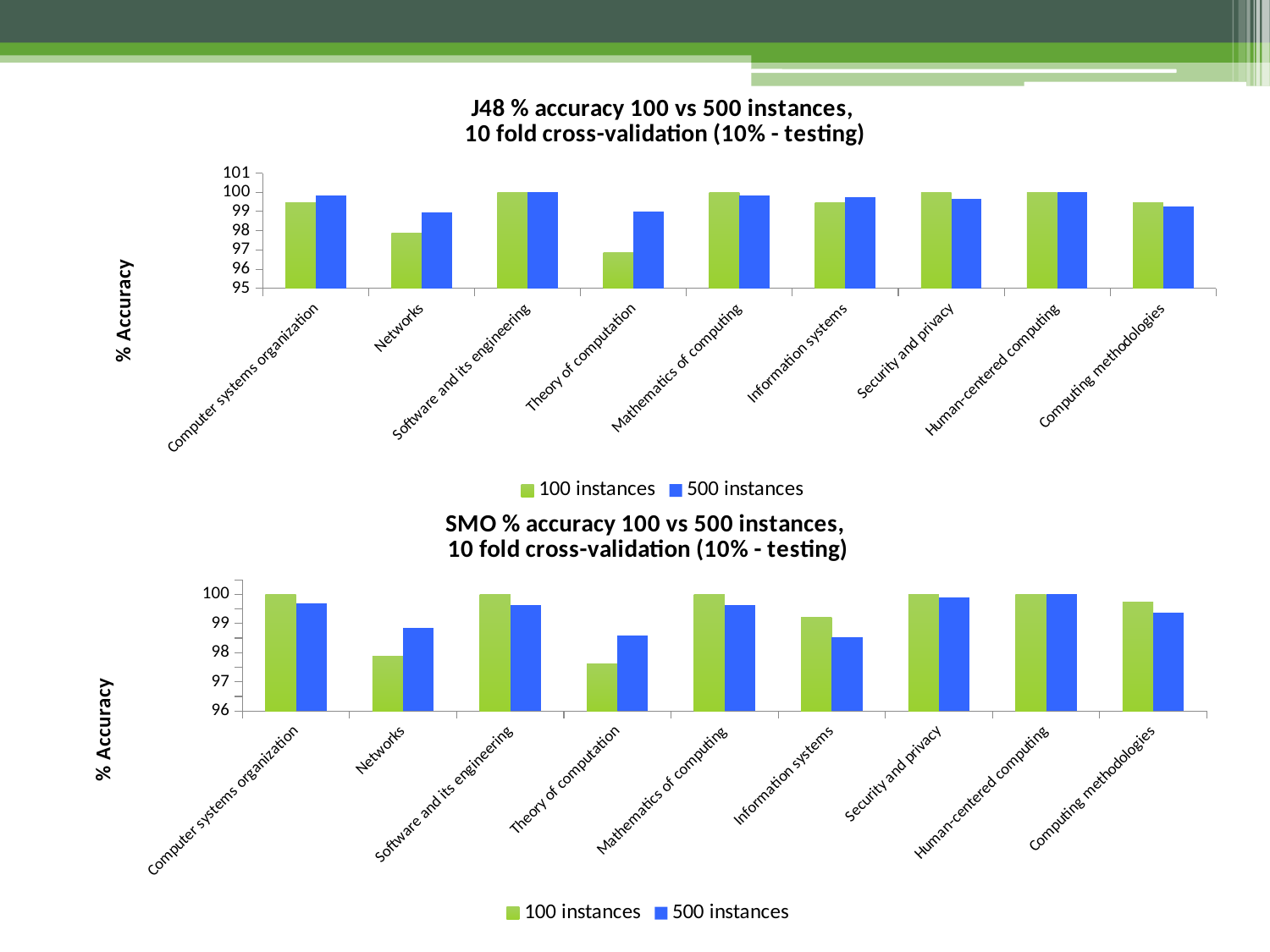
In the bottom chart (SMO % accuracy), which is larger for Information systems: 100 instances or 500 instances? 100 instances In the bottom chart (SMO % accuracy), which category has the lowest value for 100 instances? Theory of computation In the bottom chart (SMO % accuracy), is the value for Theory of computation with 500 instances greater or less than 98? greater In the bottom chart (SMO % accuracy), how many series does the legend list? 2 In the bottom chart (SMO % accuracy), which is larger for Networks: 100 instances or 500 instances? 500 instances In the top chart (J48 % accuracy), which category has the lowest value for 100 instances? Theory of computation In the top chart (J48 % accuracy), which is larger for Theory of computation: 100 instances or 500 instances? 500 instances What is the y-axis title of the bottom chart (SMO % accuracy)? % Accuracy In the top chart (J48 % accuracy), is the value for Theory of computation with 100 instances greater or less than 97? less In the top chart (J48 % accuracy), is the value for Networks with 100 instances greater or less than 98? less What kind of chart is the top chart titled 'J48 % accuracy 100 vs 500 instances'? bar chart In the top chart (J48 % accuracy), how many categories are shown on the x axis? 9